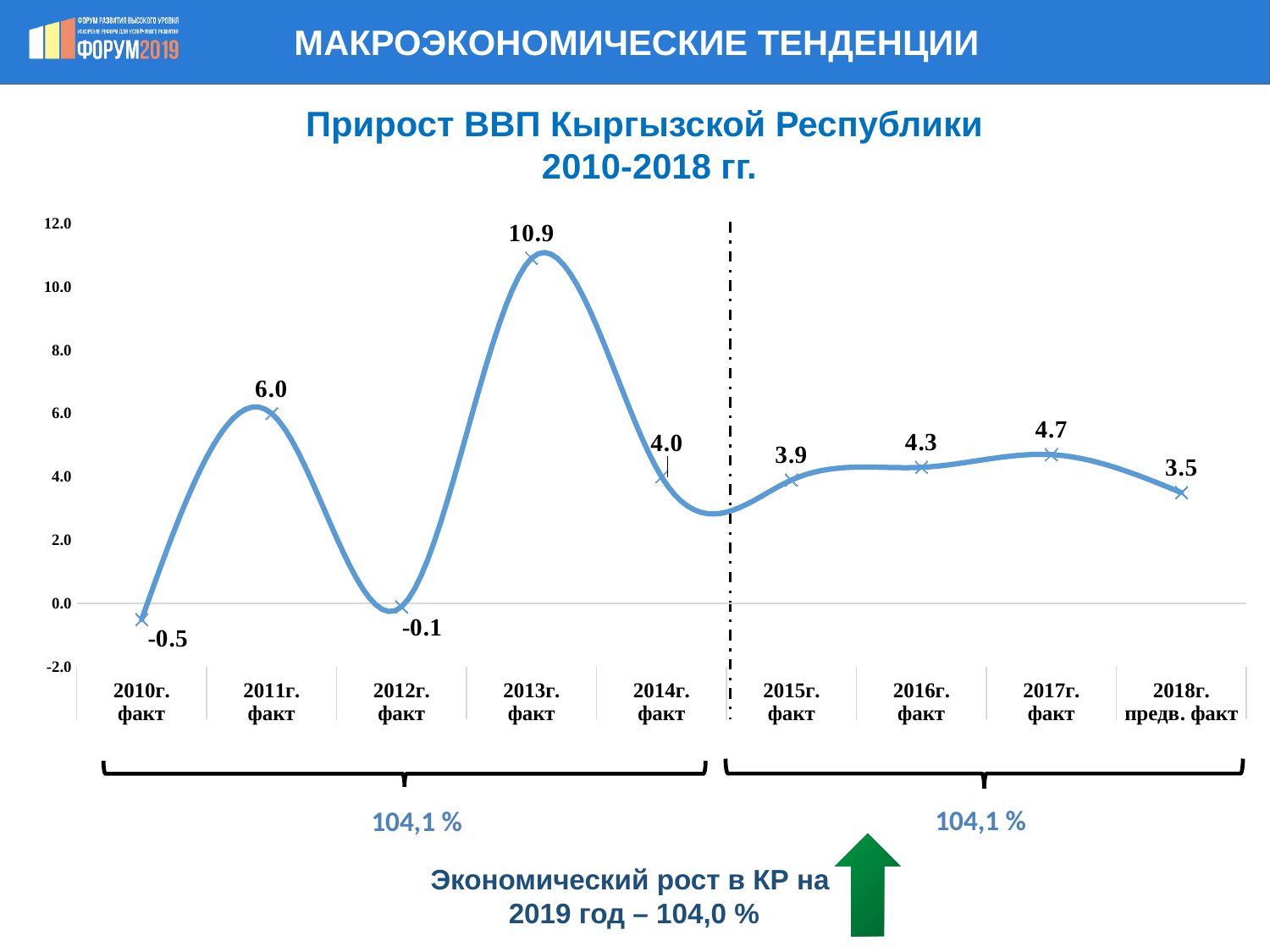
Which is larger, the value for 2011г. факт or the value for 2014г. факт? 2011г. факт What is the difference between the values for 2013г. факт and 2011г. факт? 4.9 What is the value shown for 2018г. предв. факт? 3.5 Which year has the highest GDP growth value on the chart? 2013г. факт Which year has the lowest value on the chart? 2010г. факт What is the difference between the values for 2017г. факт and 2015г. факт? 0.8 What is the title of the chart? Прирост ВВП Кыргызской Республики 2010-2018 гг. What is the GDP growth value shown for 2013г. факт? 10.9 What kind of chart is shown on the slide? line chart Is the value for 2013г. факт greater or less than 10.0? greater What is the value plotted for 2010г. факт? -0.5 How many years (data points) are plotted on the chart? 9